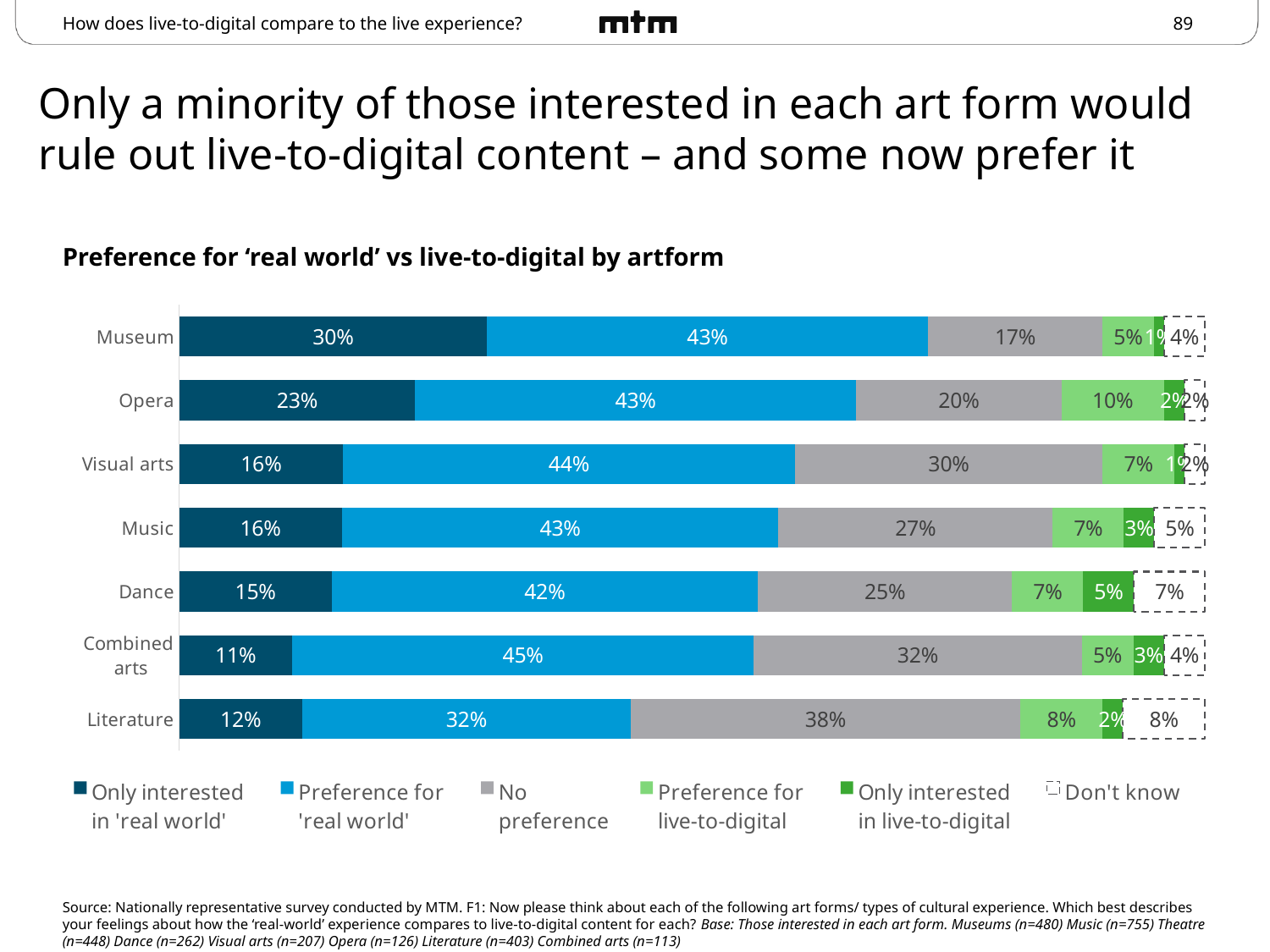
What is the difference between the 'No preference' values for Combined arts and Museum? 15% What is the 'Preference for live-to-digital' value for Opera? 10% How many art forms (categories) are shown in the chart? 7 Which is larger: the 'Preference for real world' value for Combined arts or for Dance? Combined arts Which art form has the highest 'No preference' share? Literature Which art form has the highest 'Only interested in real world' share? Museum What is the title of the chart? Preference for 'real world' vs live-to-digital by artform What is the 'No preference' value for Literature? 38% What percentage of those interested in Museums are 'Only interested in real world'? 30% How many series does the legend list? 6 What kind of chart is shown on the slide? Stacked bar chart Which art form has the lowest 'Preference for real world' share? Literature